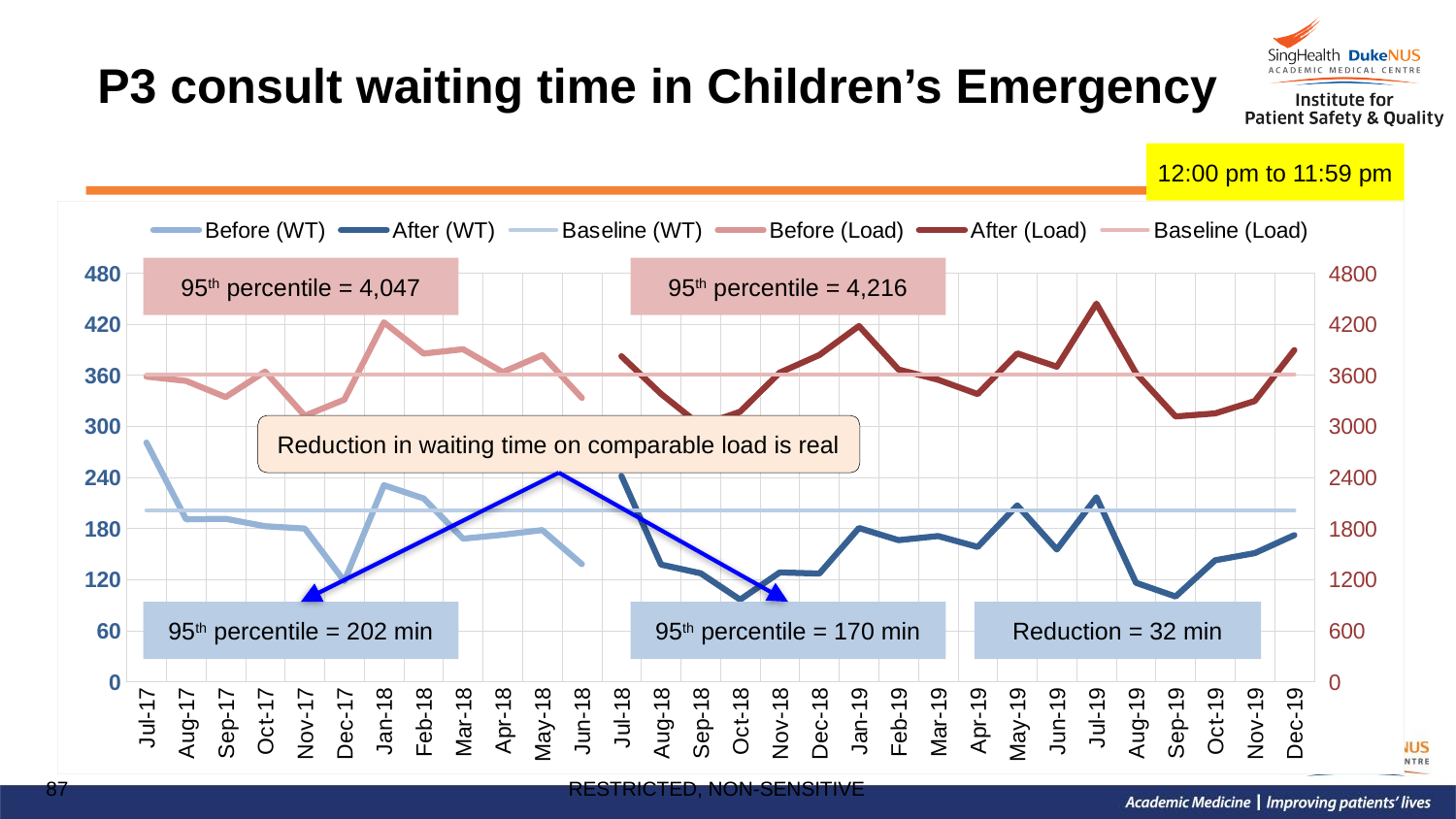
What is the stated reduction in the 95th percentile waiting time between the Before and After periods? 32 min What is the 95th percentile load stated for the After period? 4,216 In which month does the After (Load) series reach its highest value? Jul-19 How many months are shown along the x axis? 30 What is the 95th percentile waiting time stated for the After period? 170 min What kind of chart is shown on the slide? line chart How many series does the legend list? 6 What time window does the chart cover, according to the highlighted label? 12:00 pm to 11:59 pm Is the After (Load) value for Jul-19 greater or less than 4200? greater What is the 95th percentile waiting time stated for the Before period? 202 min Is the After (WT) value for Oct-18 greater or less than 120? less Is the Before (WT) value for Jul-17 greater or less than 240? greater